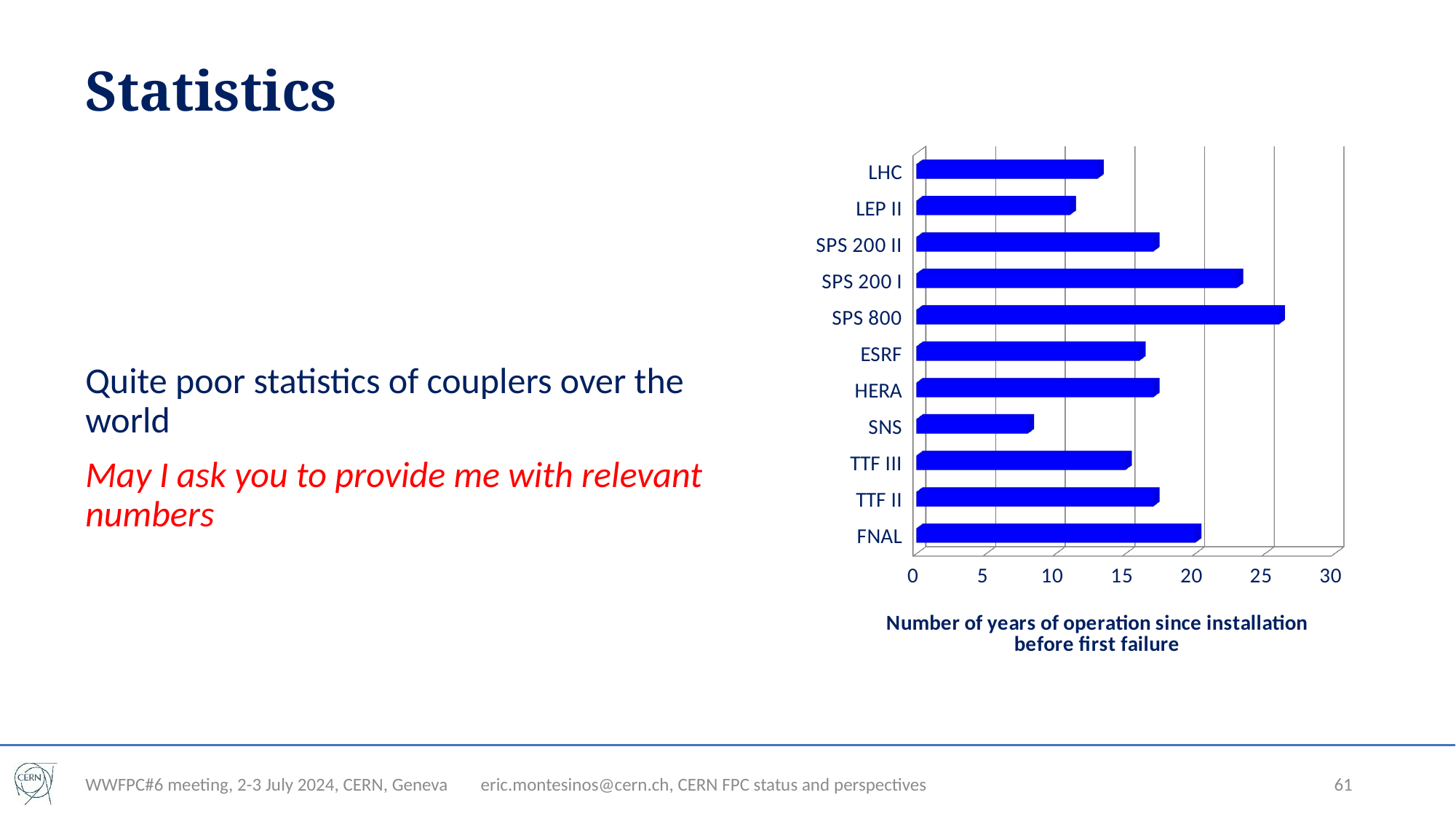
Is the value for HERA greater or less than 15? greater Which facility has the lowest number of years of operation before first failure? SNS What is the title of the horizontal axis of the chart? Number of years of operation since installation before first failure What kind of chart is shown on the slide? bar chart Is the value for SPS 200 I greater or less than 20? greater Is the value for SPS 800 greater or less than 25? greater Which has a larger value, LEP II or SNS? LEP II How many categories (facilities) are plotted in the chart? 11 Which has a larger value, SPS 200 I or LHC? SPS 200 I Which facility has the highest number of years of operation before first failure? SPS 800